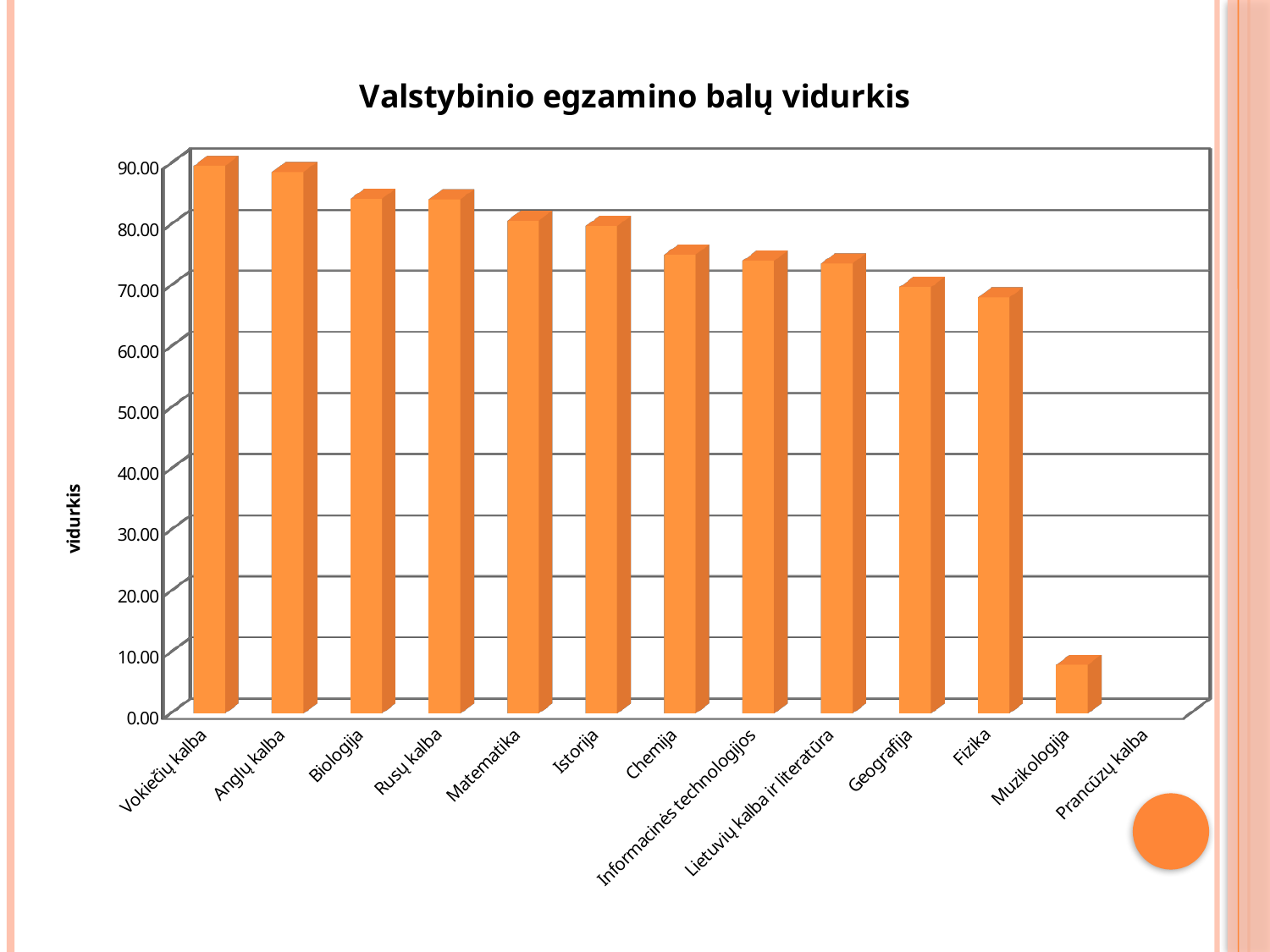
Is the value for Muzikologija greater or less than 10.00? less How many categories are listed along the horizontal axis? 13 What kind of chart is shown on the slide? bar chart Which category has the shortest visible bar? Muzikologija Which has the larger value, Matematika or Muzikologija? Matematika Is the value for Fizika greater or less than 70.00? less Do the bar values generally rise or fall from left to right along the x axis? fall What is the label on the vertical axis of the chart? vidurkis Is the value for Vokiečių kalba greater or less than 80.00? greater What is the title of the chart? Valstybinio egzamino balų vidurkis Which has the larger value, Biologija or Geografija? Biologija